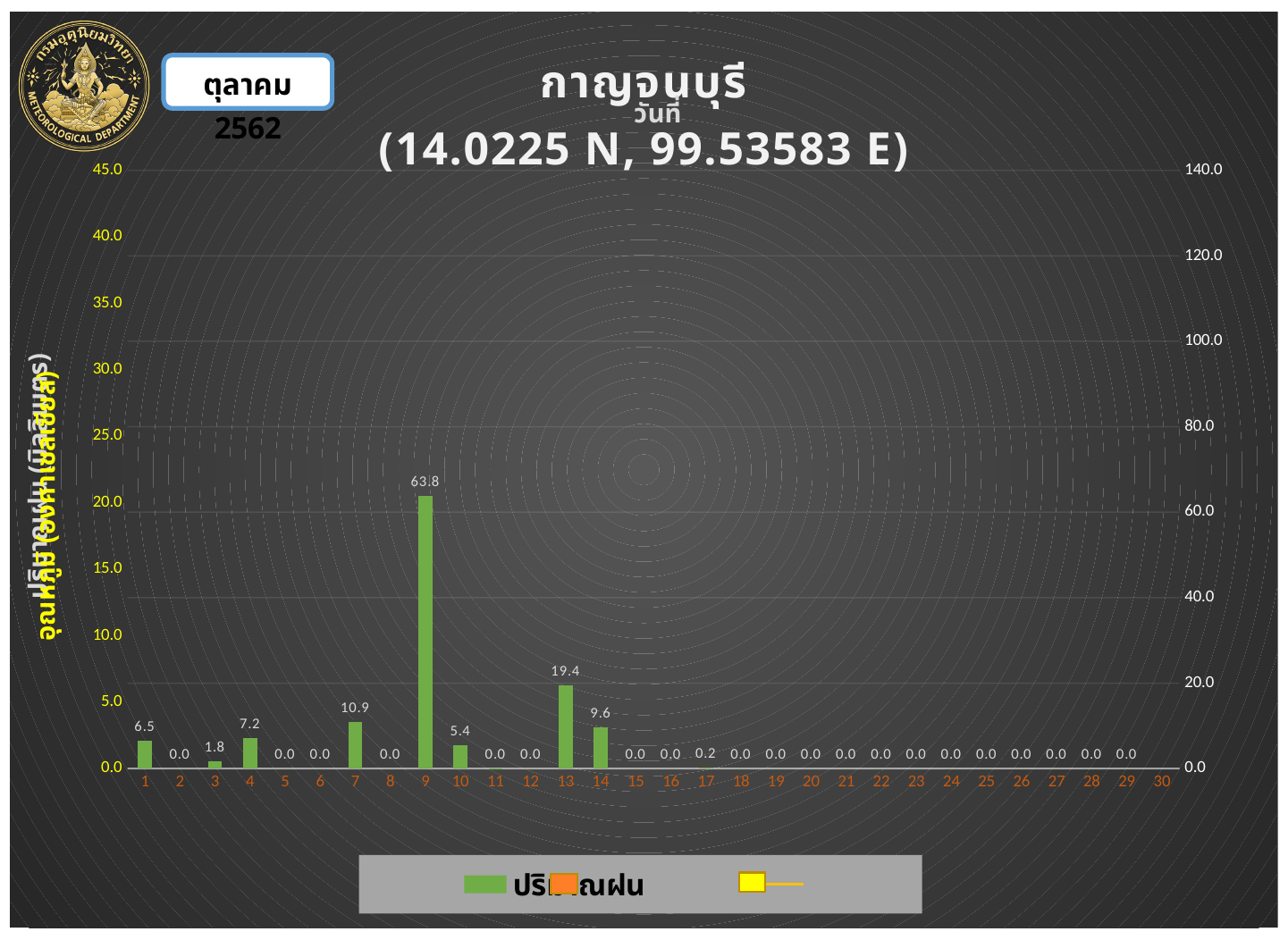
What is the value labelled on the bar for day 13? 19.4 What kind of chart is shown on the slide? bar chart Which day has the highest bar? 9 Which is larger, the value for day 10 or the value for day 14? day 14 What is the difference between the values for day 13 and day 14? 9.8 What is the difference between the values for day 9 and day 7? 52.9 Which is larger, the value for day 4 or the value for day 1? day 4 How many days are shown on the x axis? 30 What coordinates are given in the chart title? 14.0225 N, 99.53583 E What is the rainfall value shown for day 9? 63.8 What is the value shown for day 7? 10.9 What is the value shown for day 17? 0.2